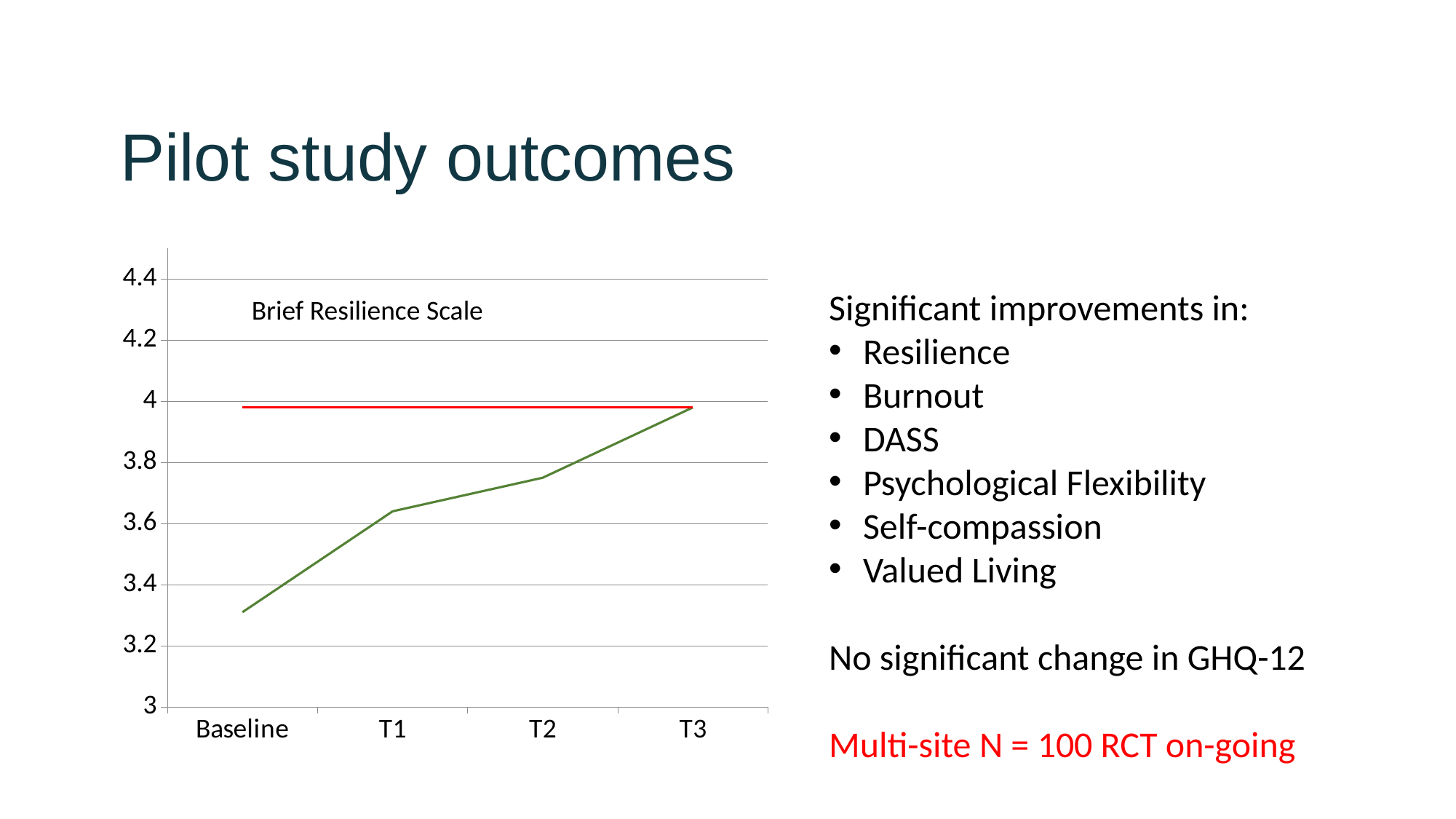
What kind of chart is shown on the slide? line chart At which time point is the green line lowest? Baseline What is the title of the chart? Brief Resilience Scale What colour is the horizontal reference line drawn across the chart? red At which time point is the green line highest? T3 Is the T1 value of the green line greater or less than 3.6? greater How many time points are plotted along the x axis of the chart? 4 Does the green line rise or fall from Baseline to T3? rises Which is larger on the green line, the value at T1 or the value at Baseline? T1 Is the Baseline value of the green line greater or less than 3.4? less Is the T2 value of the green line greater or less than 3.8? less